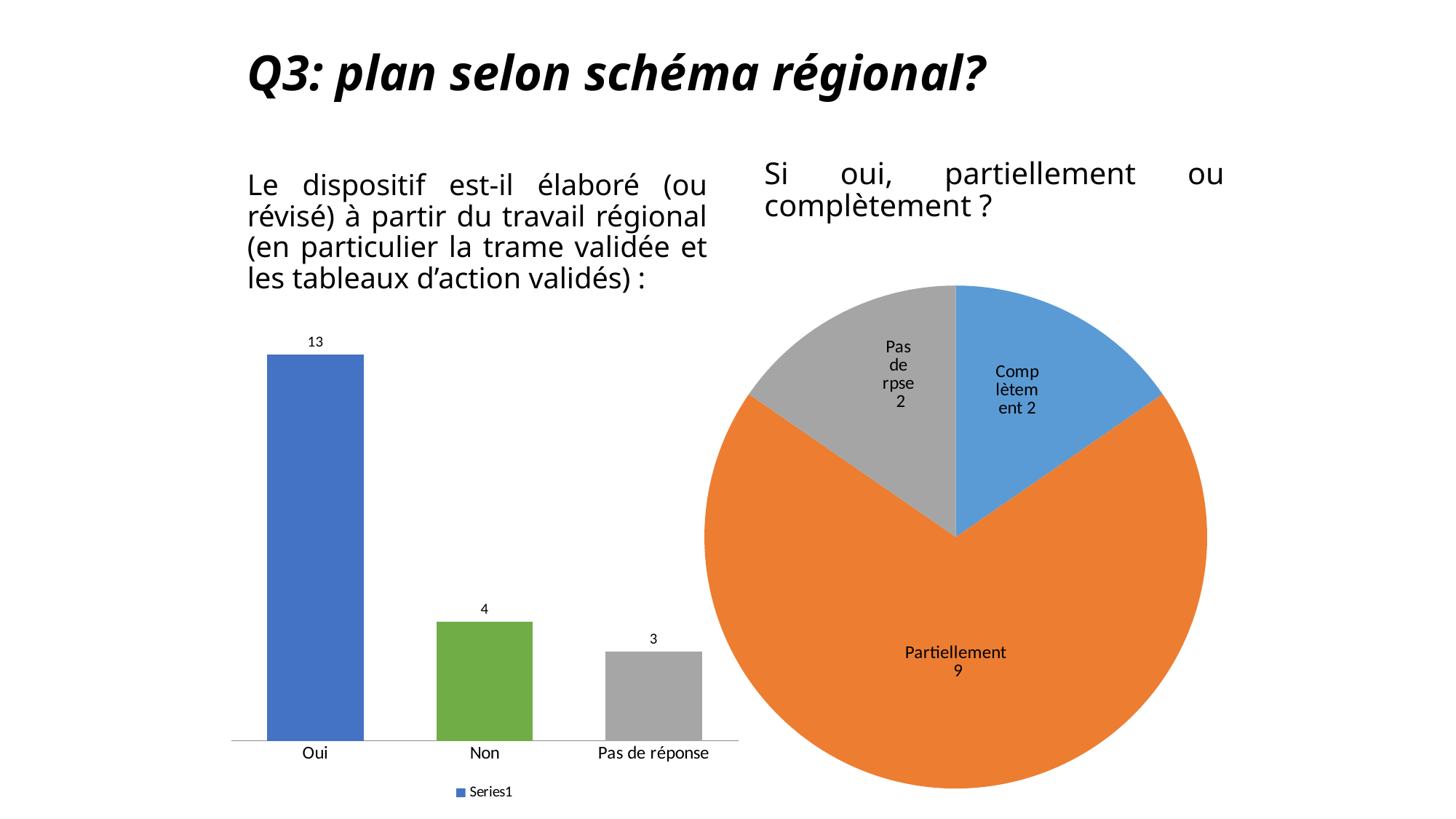
What kind of chart is the chart on the left of the slide? Bar chart In the bar chart on the left, what is the value for Non? 4 In the bar chart on the left, how many categories are shown? 3 In the bar chart on the left, what is the value for Oui? 13 In the bar chart on the left, which category has the lowest value? Pas de réponse In the bar chart on the left, which category has the highest value? Oui In the bar chart on the left, what is the value for Pas de réponse? 3 In the pie chart on the right, what is the value for Partiellement? 9 In the pie chart on the right, what is the difference between the values for Partiellement and Complètement? 7 In the bar chart on the left, what is the difference between the values for Oui and Non? 9 What kind of chart is the chart on the right of the slide? Pie chart In the pie chart on the right, which slice is the largest? Partiellement